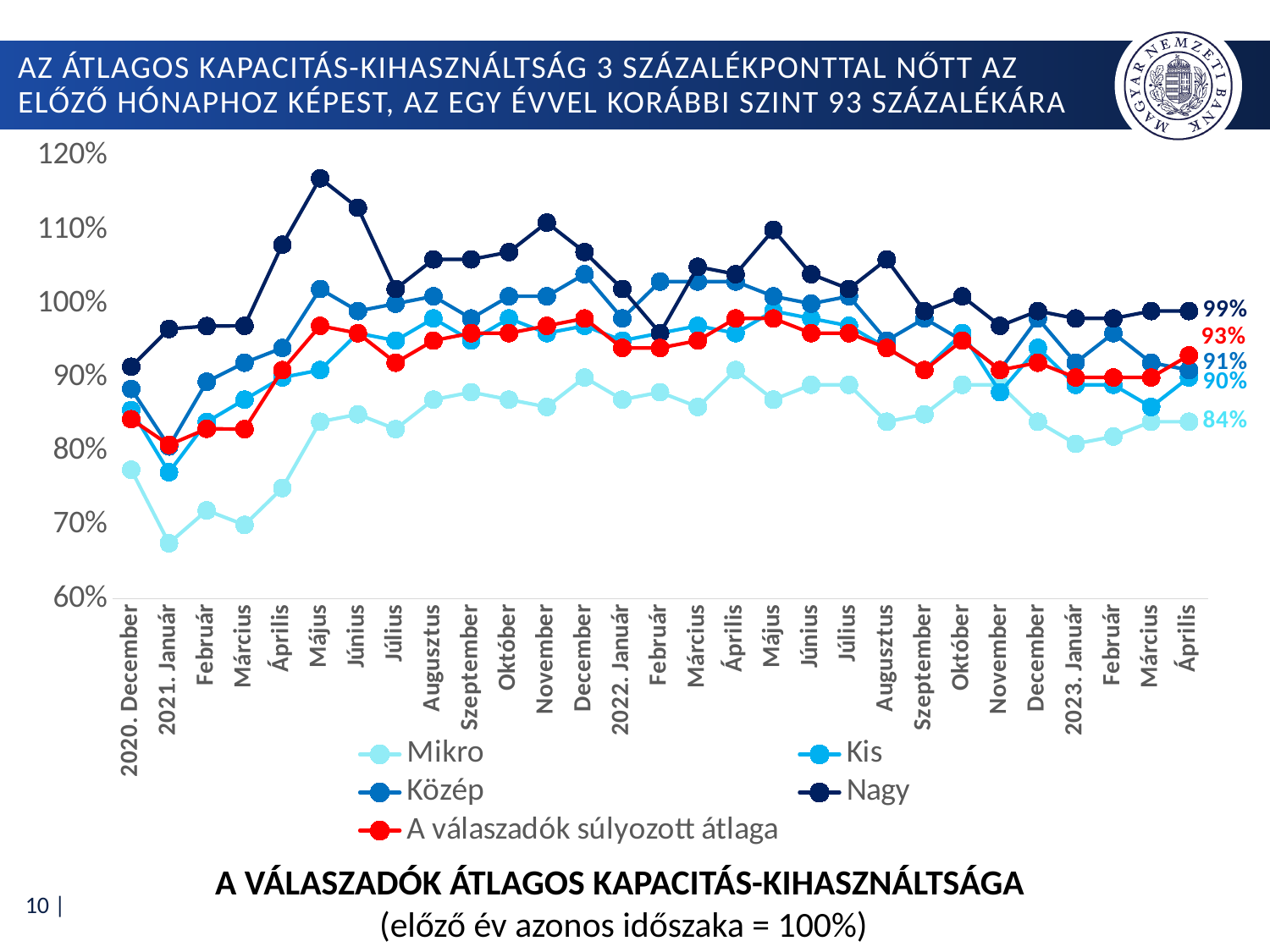
What is the value for the Kis series in 2023 Április? 90% What is the value for the Közép series in 2023 Április? 91% Is the value for the Nagy series in 2021 Május greater or less than 110%? greater Which series has the lowest value in 2023 Április? Mikro How many series does the legend list? 5 What is the value for the Nagy series in 2023 Április? 99% What is the value for 'A válaszadók súlyozott átlaga' in 2023 Április? 93% What is the difference between the Nagy and Mikro values in 2023 Április? 15 percentage points What is the value for the Mikro series in 2023 Április? 84% Is the value for the Mikro series in 2021 Január greater or less than 70%? less Which series has the highest value in 2023 Április? Nagy What kind of chart is shown on the slide? line chart